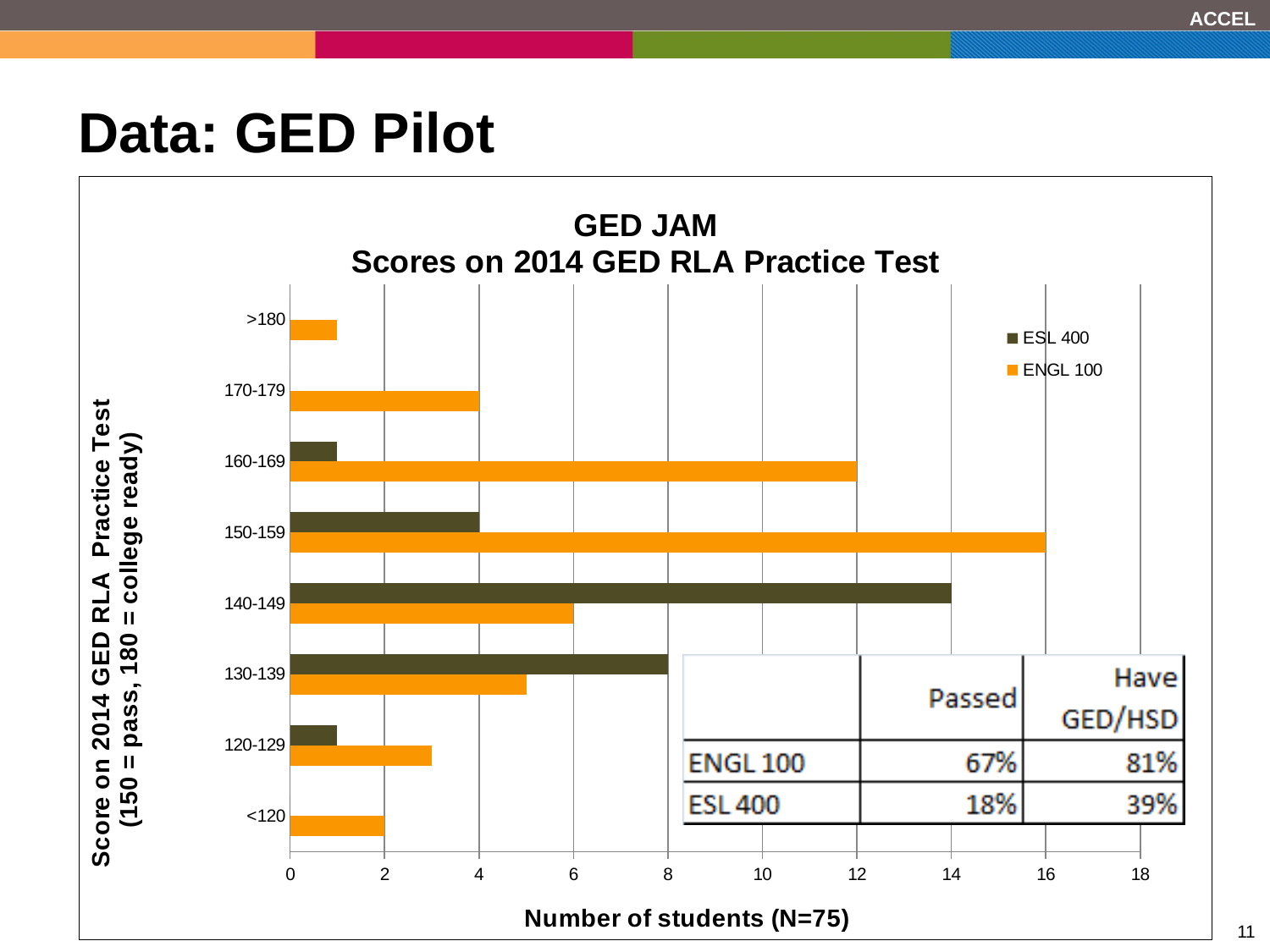
How many score ranges are shown on the vertical axis? 8 Which score range has the most ESL 400 students? 140-149 What kind of chart is shown on the slide? bar chart Which score range has the most ENGL 100 students? 150-159 Is the number of ENGL 100 students in the 130-139 range greater or less than 6? less How many ENGL 100 students scored 160-169? 12 In the 150-159 range, how many more ENGL 100 students are there than ESL 400 students? 12 How many series does the legend list? 2 What is the title of the horizontal axis? Number of students (N=75) How many ENGL 100 students scored 150-159? 16 How many ESL 400 students scored 140-149? 14 In the 140-149 range, which series has more students, ESL 400 or ENGL 100? ESL 400